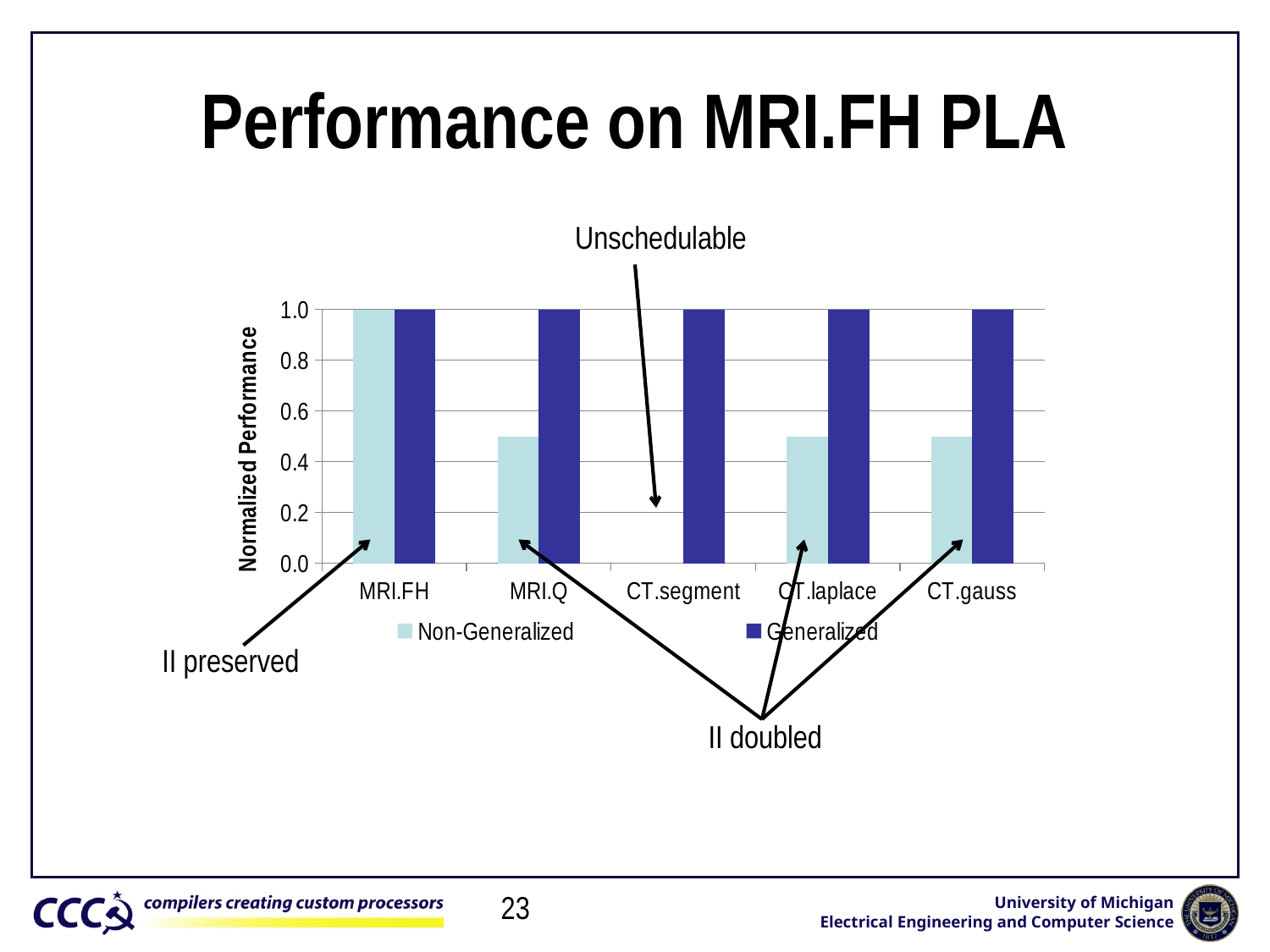
How many series does the legend list? 2 Is the Non-Generalized value for MRI.Q greater or less than 0.8? less Which category has the highest Non-Generalized value? MRI.FH What is the Generalized value for MRI.Q? 1.0 What is the Generalized value for CT.laplace? 1.0 Which category has no Non-Generalized bar? CT.segment What is the Non-Generalized value for MRI.FH? 1.0 What kind of chart is shown on the slide? bar chart Is the Non-Generalized value for CT.gauss greater or less than 0.4? greater How many categories are shown on the x axis? 5 Which is larger for CT.laplace, the Non-Generalized value or the Generalized value? Generalized What is the label of the y axis? Normalized Performance